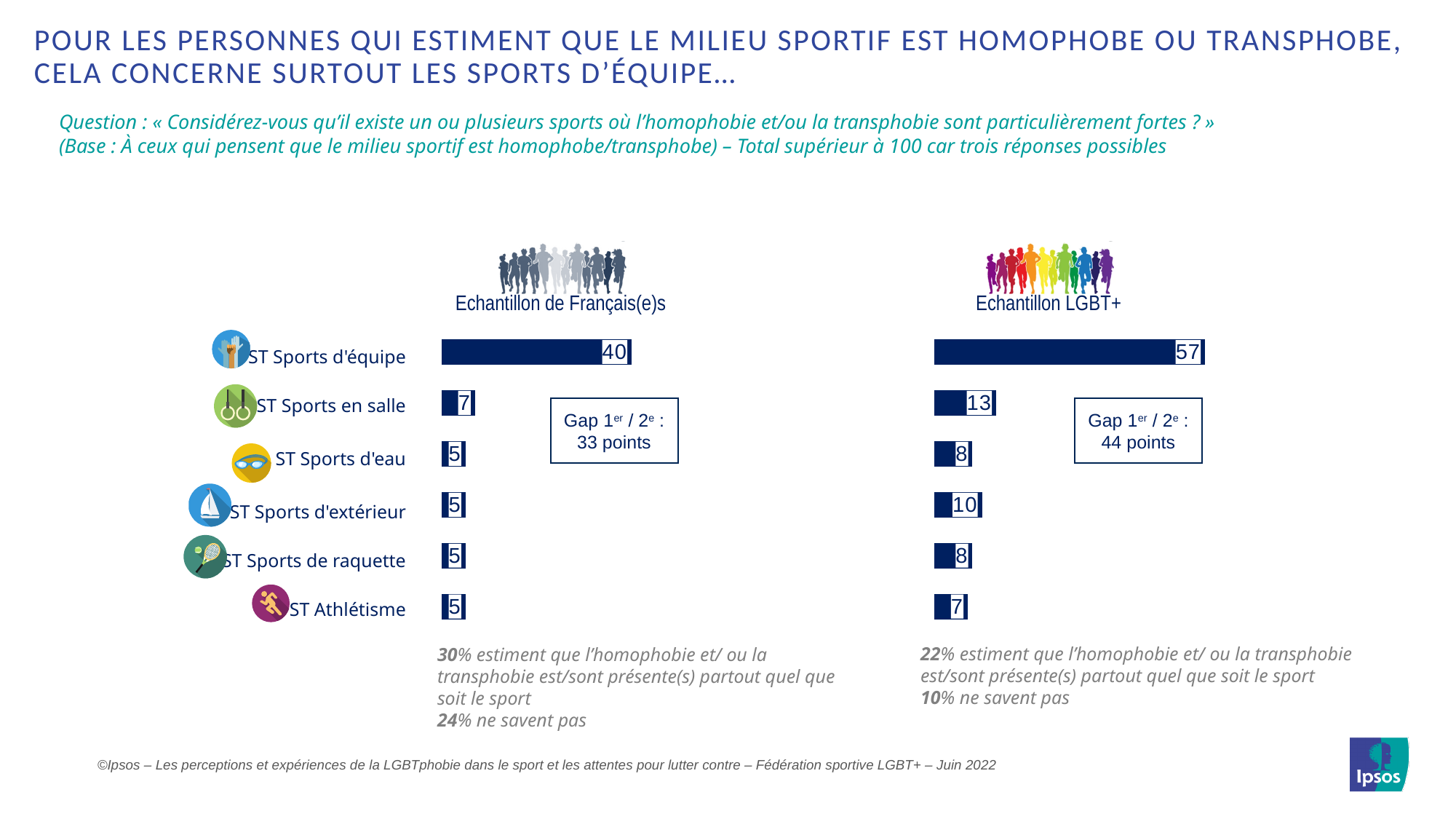
In the Echantillon LGBT+ chart, what is the value for ST Sports d'équipe? 57 In the Echantillon LGBT+ chart, which category has the lowest value? ST Athlétisme In the Echantillon de Français(e)s chart, what is the difference between ST Sports d'équipe and ST Sports en salle? 33 How many categories are shown in the Echantillon de Français(e)s chart? 6 In the Echantillon LGBT+ chart, what is the value for ST Sports d'extérieur? 10 In the Echantillon de Français(e)s chart, which category has the highest value? ST Sports d'équipe Which is larger: ST Sports en salle in the Echantillon LGBT+ chart or ST Sports en salle in the Echantillon de Français(e)s chart? Echantillon LGBT+ In the Echantillon LGBT+ chart, what is the value for ST Sports en salle? 13 What kind of chart is the Echantillon LGBT+ chart? Bar chart In the Echantillon LGBT+ chart, what is the value for ST Athlétisme? 7 In the Echantillon de Français(e)s chart, what is the value for ST Sports d'équipe? 40 In the Echantillon LGBT+ chart, what is the difference between ST Sports d'équipe and ST Sports en salle? 44